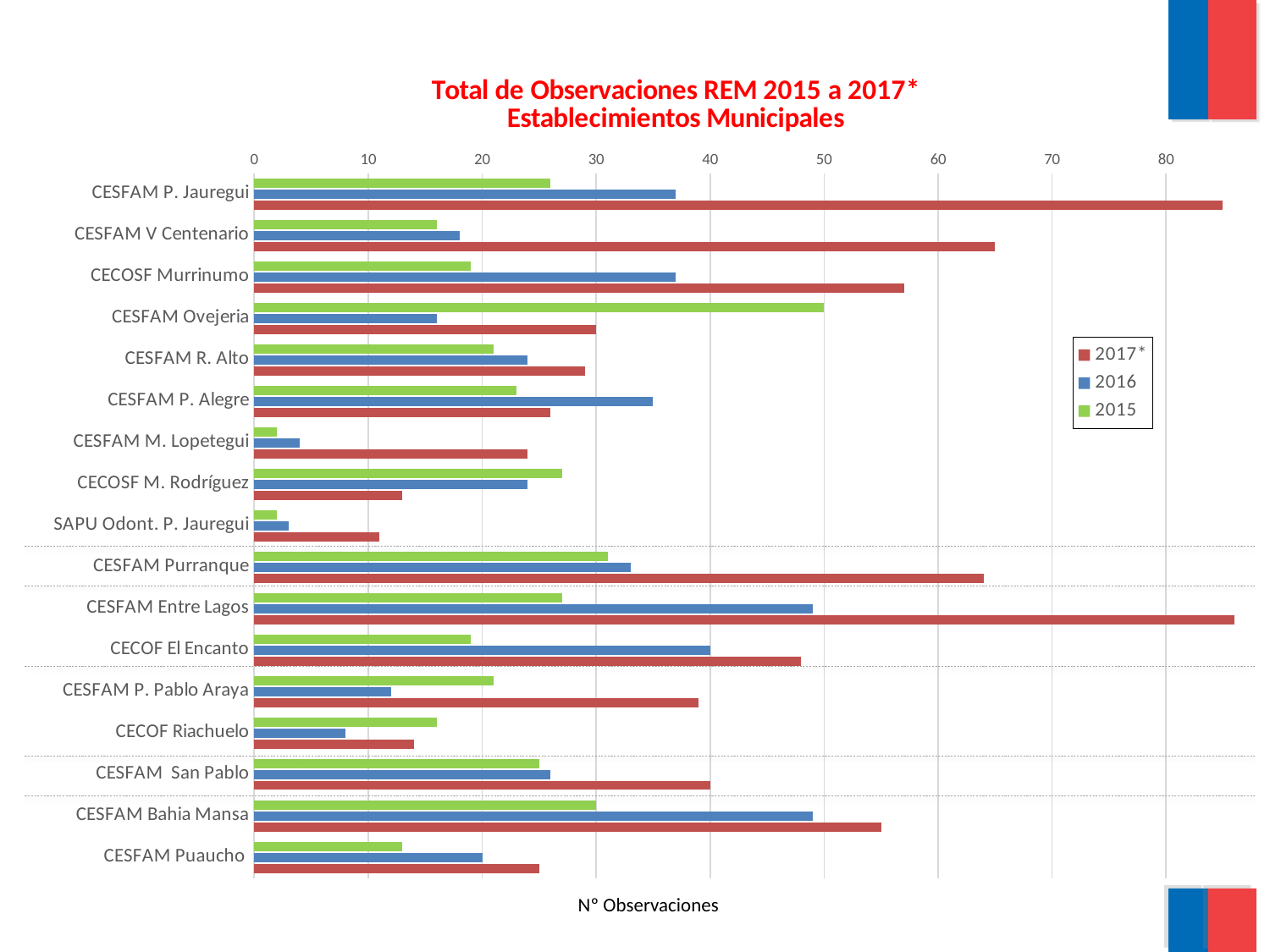
Which establishment has the highest 2015 value? CESFAM Ovejeria How many establishments (categories) are shown on the chart? 17 Which establishment has the lowest 2017* value? SAPU Odont. P. Jauregui What is the label on the horizontal axis? N° Observaciones What kind of chart is shown on the slide? bar chart Which is larger for CECOSF M. Rodríguez, the 2017* value or the 2015 value? 2015 Which is larger for CESFAM Entre Lagos, the 2016 value or the 2015 value? 2016 How many series does the legend list? 3 Is the 2015 value for CESFAM Ovejeria greater or less than 40? greater What is the title of the chart? Total de Observaciones REM 2015 a 2017* Establecimientos Municipales Is the 2016 value for CESFAM M. Lopetegui greater or less than 10? less Is the 2017* value for CESFAM V Centenario greater or less than 60? greater